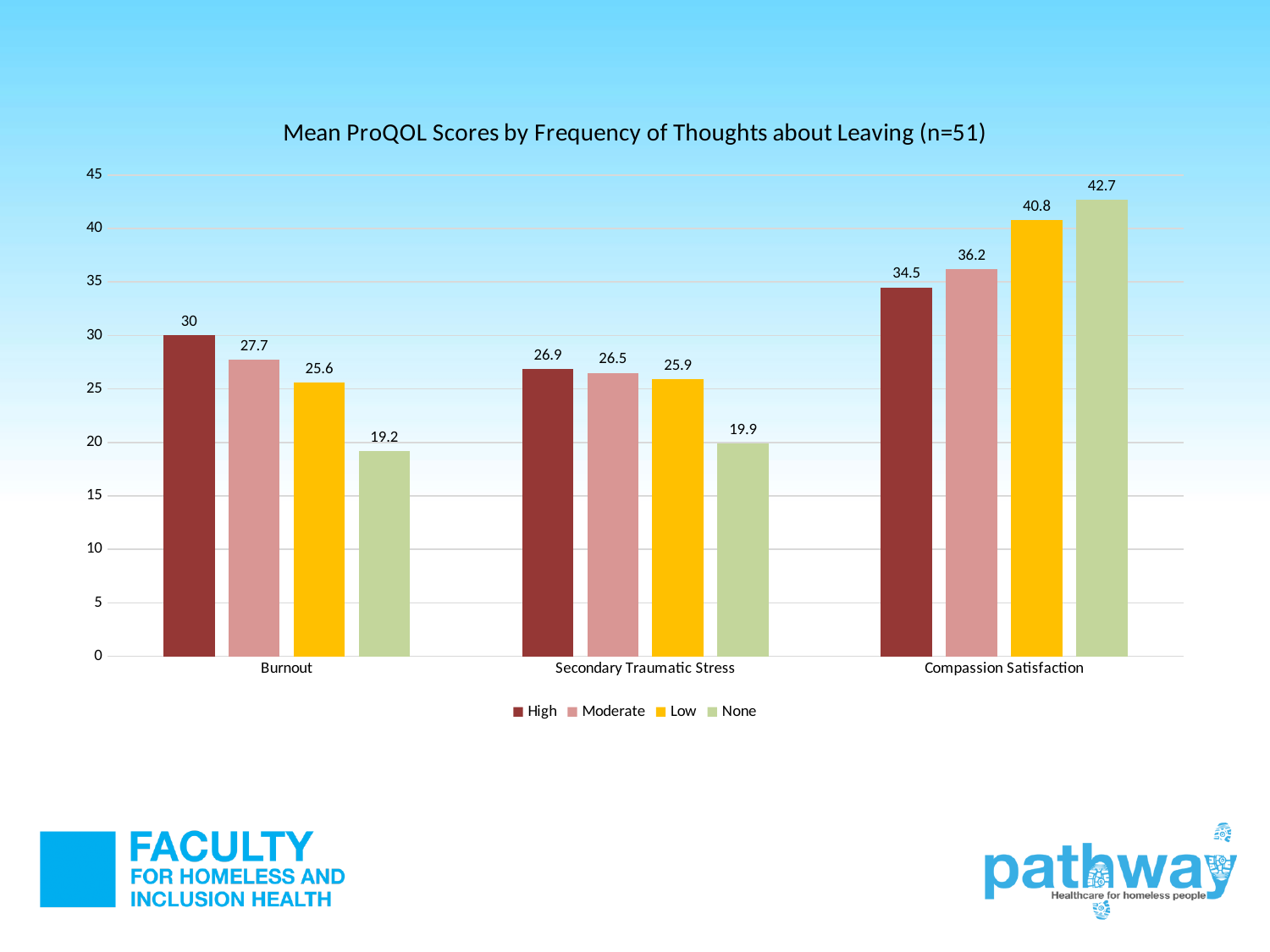
How many categories are shown on the x axis? 3 What is the mean Burnout score for the High group? 30 What is the difference between the High and None groups' Burnout scores? 10.8 What colour represents the Low group in the chart? Yellow What is the mean Secondary Traumatic Stress score for the Low group? 25.9 Which group has the lowest Burnout score? None What is the mean Compassion Satisfaction score for the None group? 42.7 What is the title of the chart? Mean ProQOL Scores by Frequency of Thoughts about Leaving (n=51) What kind of chart is shown on the slide? Bar chart Which is larger: the Moderate group's Compassion Satisfaction score or the Low group's Compassion Satisfaction score? Low How many series does the legend list? 4 Which group has the highest Compassion Satisfaction score? None